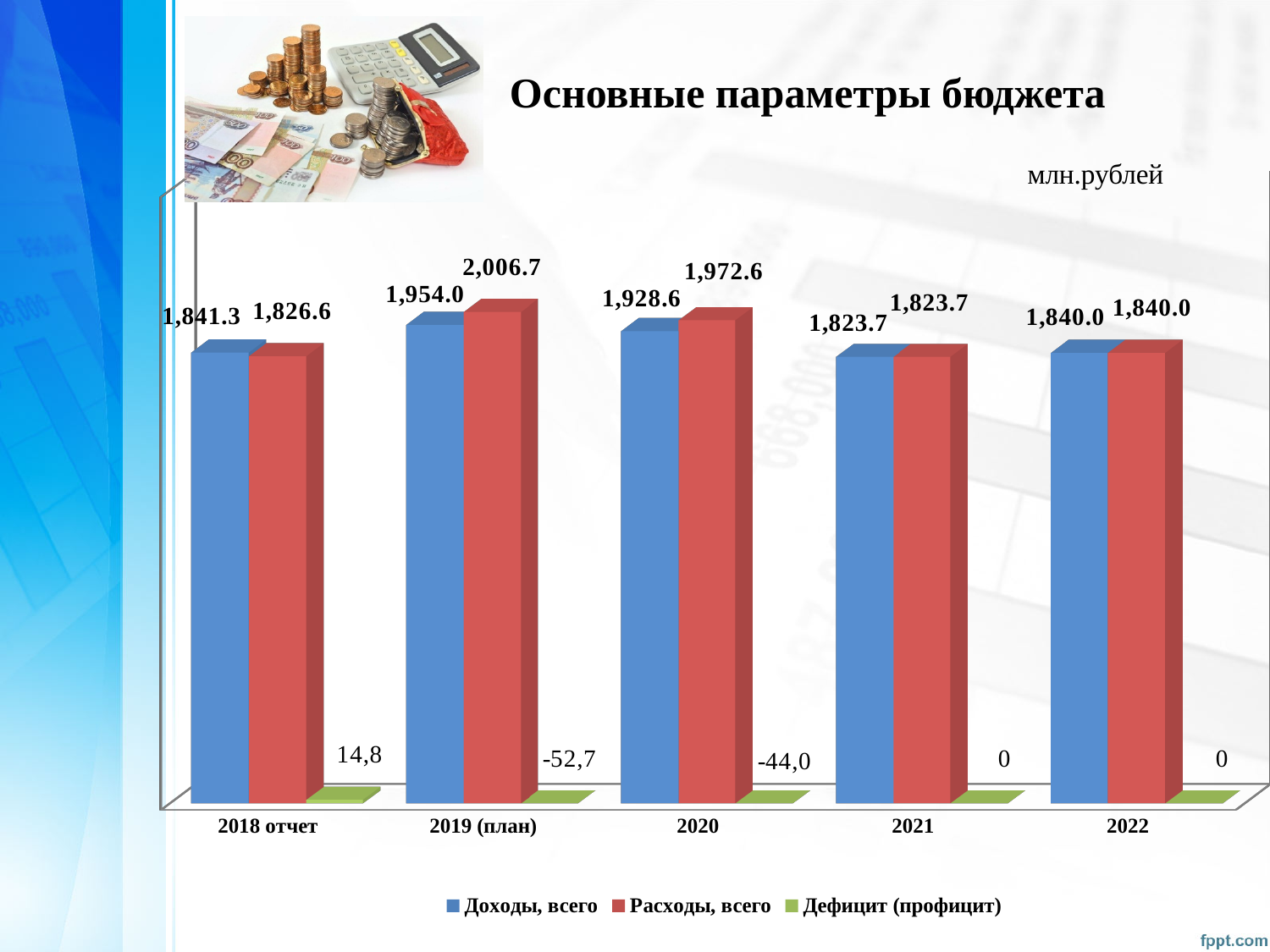
What is the difference between Расходы, всего and Доходы, всего for 2019 (план)? 52.7 What is the value of Дефицит (профицит) for 2018 отчет? 14,8 What is the title of the slide? Основные параметры бюджета How many series does the legend list? 3 Which is larger for 2018 отчет: Доходы, всего or Расходы, всего? Доходы, всего What is the value of Дефицит (профицит) for 2019 (план)? -52,7 Which category has the highest value for Расходы, всего? 2019 (план) What kind of chart is shown on the slide? Bar chart What is the value of Доходы, всего for 2019 (план)? 1,954.0 What is the value of Расходы, всего for 2020? 1,972.6 Which category has the lowest value for Доходы, всего? 2021 How many categories are shown on the x axis? 5